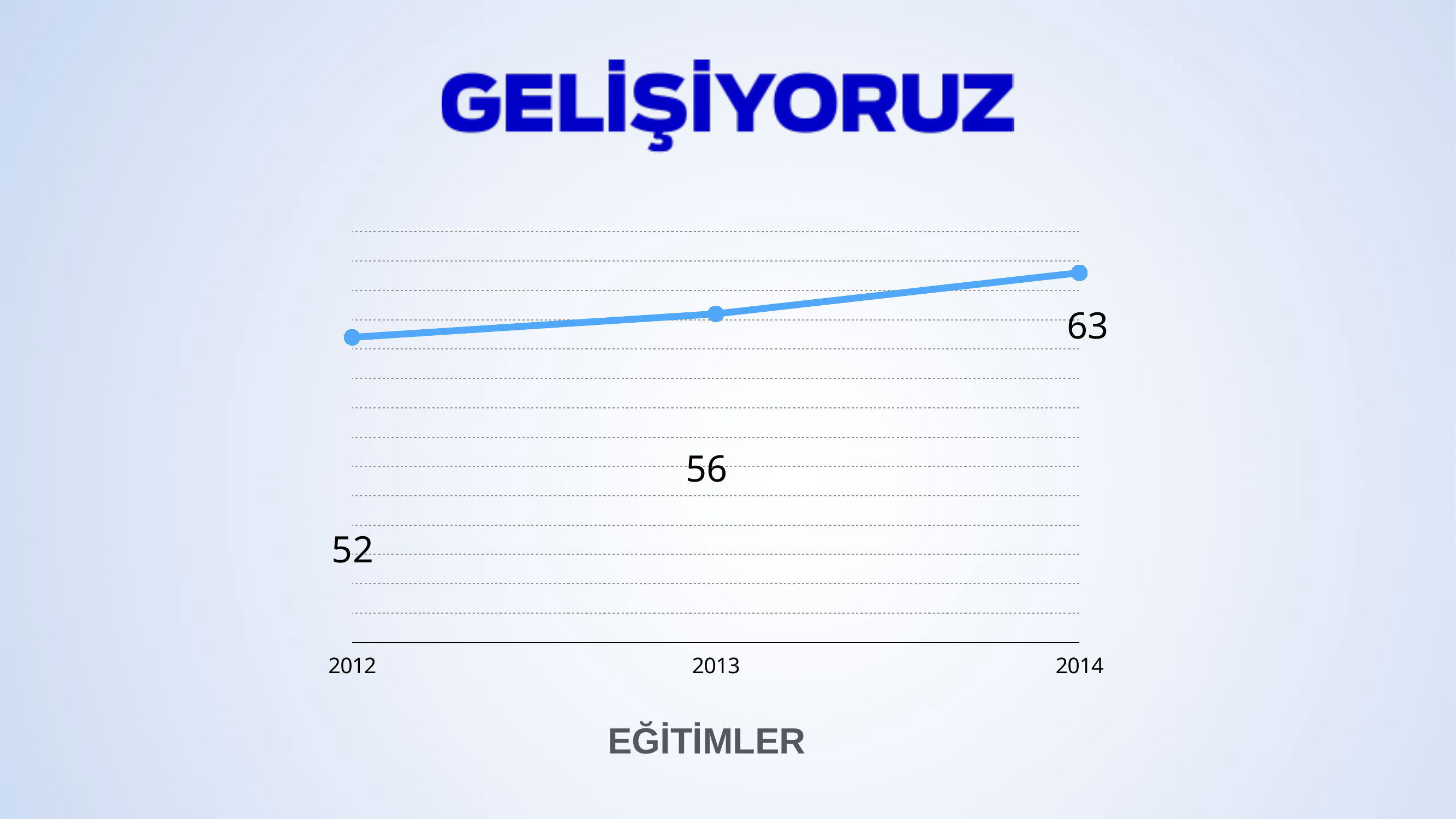
Which is larger, the value for 2013 or the value for 2014? 2014 What is the difference between the values for 2013 and 2012? 4 What is the value for 2014? 63 What is the value for 2012? 52 Which year has the lowest value? 2012 How many years are plotted on the chart? 3 What kind of chart is shown on the slide? line chart What label appears below the chart's x axis? EĞİTİMLER What is the value for 2013? 56 Which year has the highest value? 2014 Do the values rise or fall from 2012 to 2014? rise What is the difference between the values for 2014 and 2012? 11